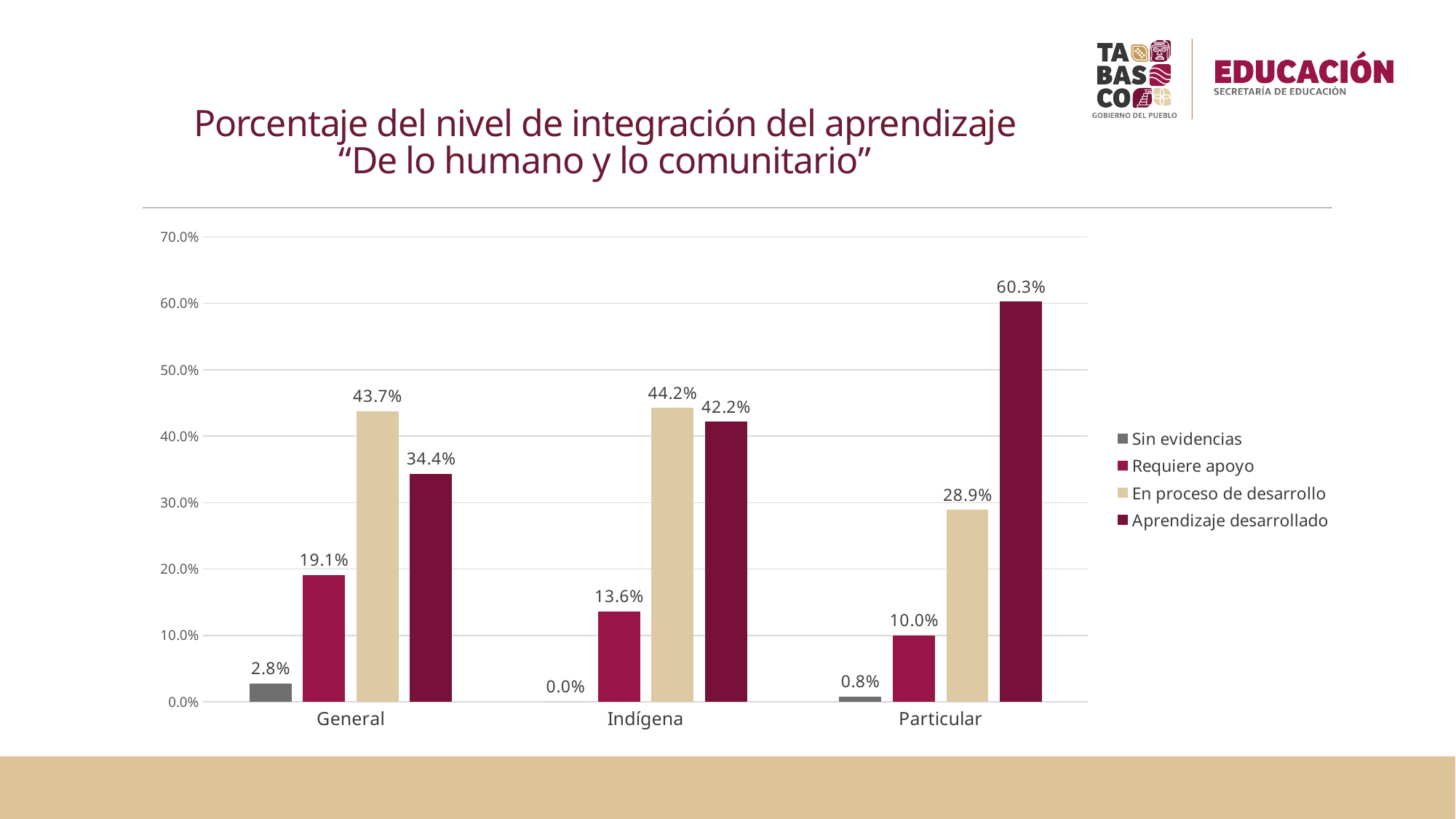
What is the value for "Requiere apoyo" in the General category? 19.1% Which is larger in the General category: "En proceso de desarrollo" or "Aprendizaje desarrollado"? En proceso de desarrollo How many series does the legend list? 4 What is the value for "Sin evidencias" in the Particular category? 0.8% What kind of chart is shown on the slide? Bar chart Which category has the lowest value for "Requiere apoyo"? Particular Which category has the highest value for "Aprendizaje desarrollado"? Particular How many categories are shown on the x axis? 3 What is the value for "Aprendizaje desarrollado" in the Particular category? 60.3% What is the value for "En proceso de desarrollo" in the Indígena category? 44.2% What is the difference between "Aprendizaje desarrollado" in Particular and in General? 25.9% What is the value for "Sin evidencias" in the Indígena category? 0.0%